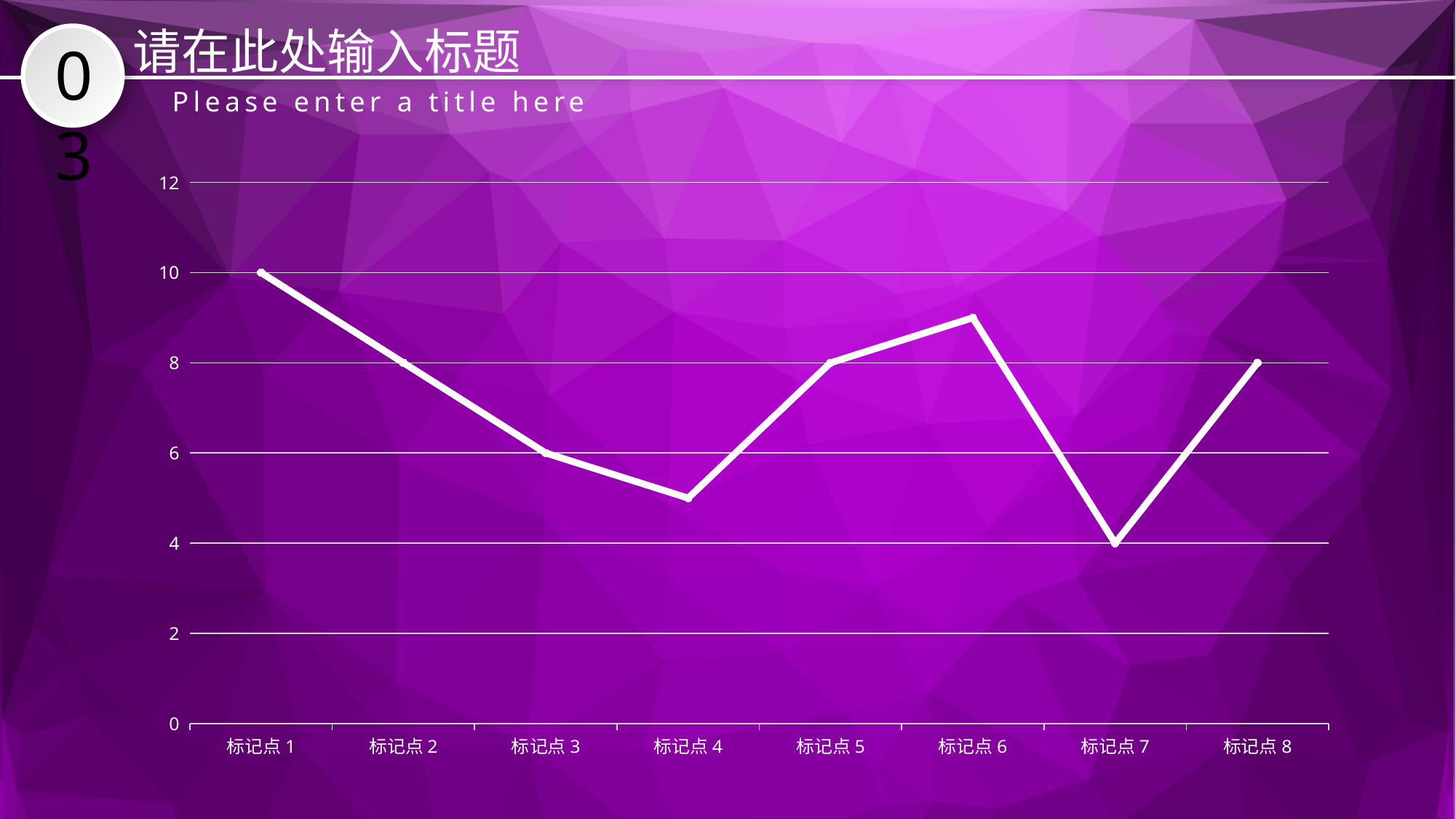
What is the value at 标记点 7? 4 Which point has the highest value? 标记点 1 What type of chart is shown on the slide? line chart Which is larger, the value at 标记点 3 or the value at 标记点 7? 标记点 3 What is the difference between the values at 标记点 1 and 标记点 7? 6 How many data points are plotted on the line chart? 8 What is the value at 标记点 8? 8 Which point has the lowest value? 标记点 7 What is the value at 标记点 1? 10 Do the values rise or fall from 标记点 1 to 标记点 4? fall What is the value at 标记点 3? 6 Is the value for 标记点 4 greater or less than 6? less